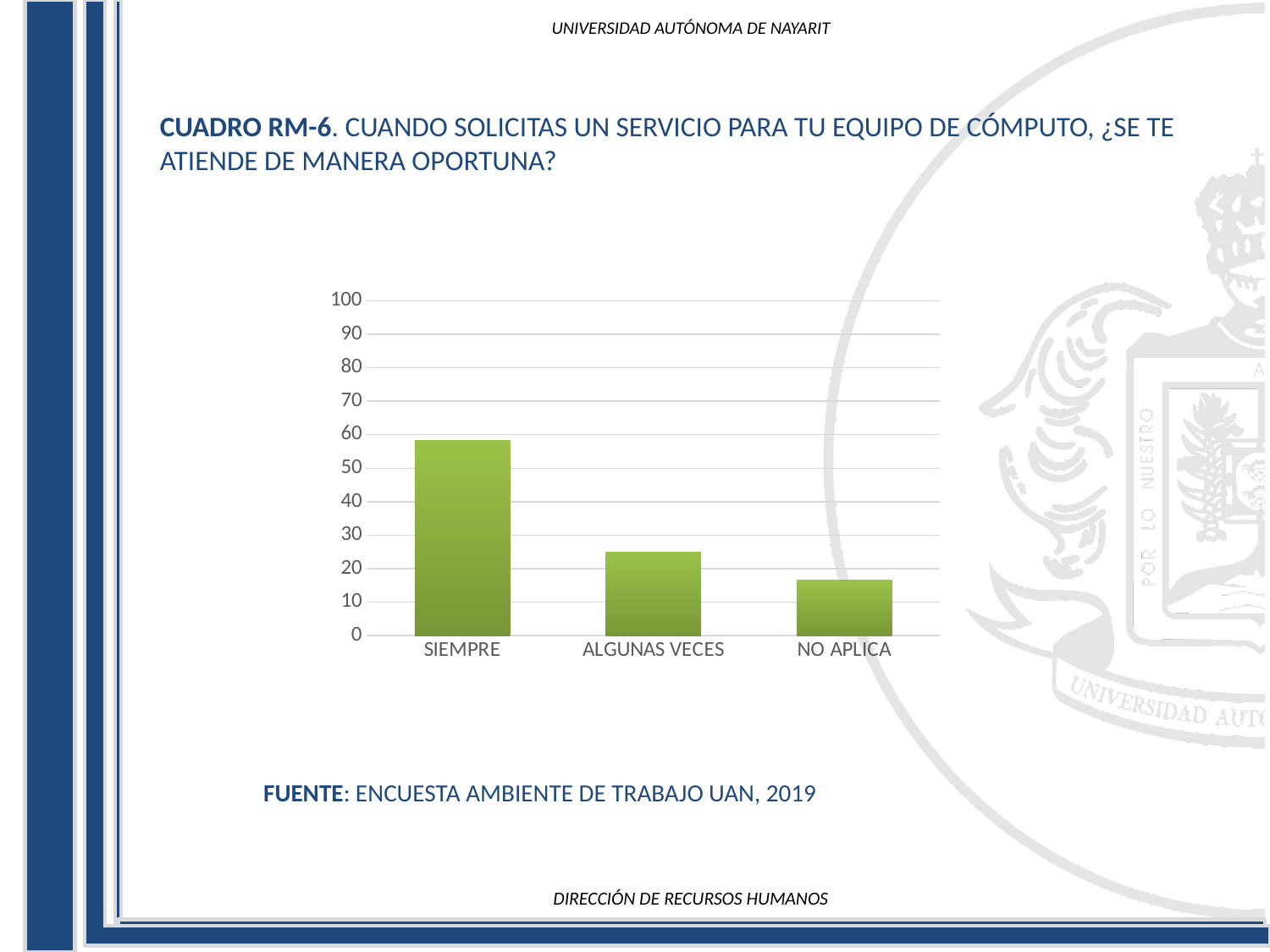
How many categories are shown on the x axis of the chart? 3 Which is larger, the value for ALGUNAS VECES or the value for NO APLICA? ALGUNAS VECES Is the value for NO APLICA greater or less than 20? less Is the value for ALGUNAS VECES greater or less than 30? less Is the value for ALGUNAS VECES greater or less than 20? greater Do the bar values rise or fall from left to right along the x axis? fall What is the highest value shown on the y axis of the chart? 100 Which category has the lowest bar in the chart? NO APLICA What kind of chart is shown on the slide? bar chart Which category has the highest bar in the chart? SIEMPRE